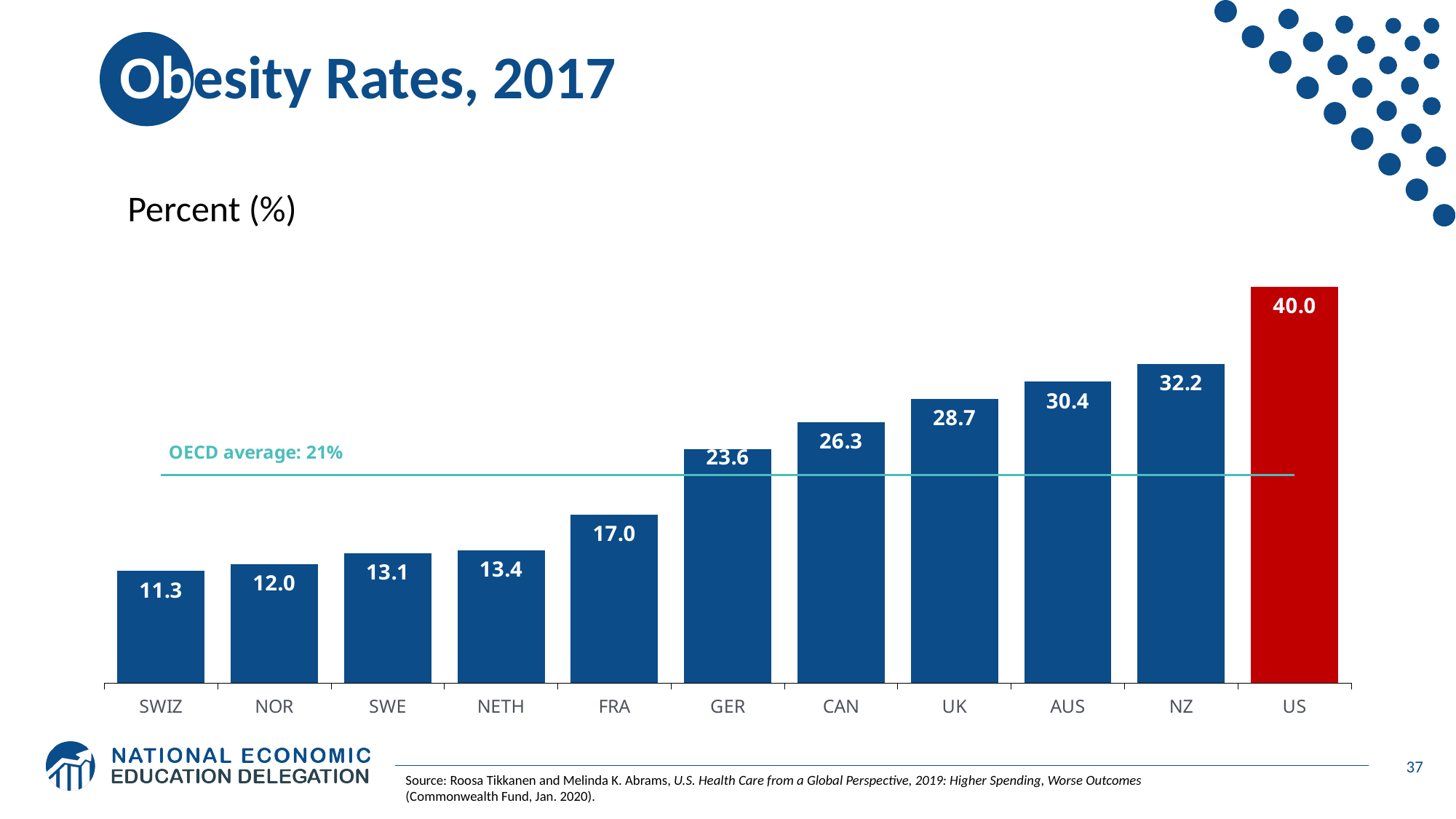
How many countries are shown on the chart? 11 Which has a higher obesity rate, CAN or UK? UK What OECD average value is marked by the horizontal line on the chart? 21% What is the difference between the obesity rates of the US and NZ? 7.8 What kind of chart is shown on the slide? Bar chart What is the obesity rate shown for Switzerland (SWIZ)? 11.3 Which country has the lowest obesity rate on the chart? SWIZ What is the obesity rate shown for the US? 40.0 Which country has the highest obesity rate on the chart? US Which country's bar is coloured red rather than blue? US Do the obesity rates rise or fall moving from left to right along the x axis? Rise What is the obesity rate shown for Germany (GER)? 23.6